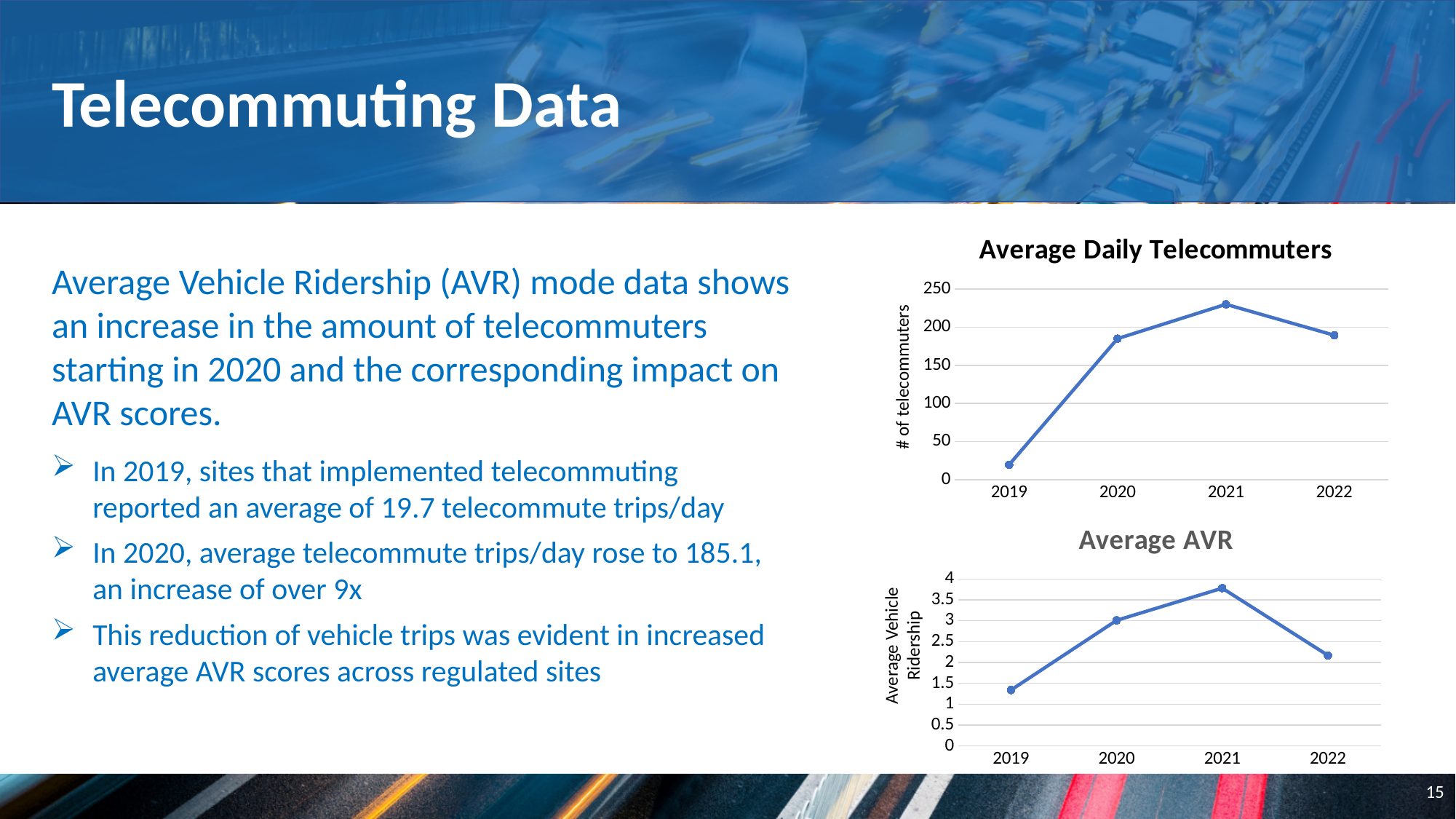
In the "Average Daily Telecommuters" chart, which year has the lowest value? 2019 What kind of chart is the "Average Daily Telecommuters" chart? line chart In the "Average Daily Telecommuters" chart, which year has the highest value? 2021 In the "Average Daily Telecommuters" chart, do the values rise or fall from 2019 to 2021? rise In the "Average AVR" chart, is the value for 2021 greater or less than 3.5? greater In the "Average AVR" chart, which year has the lowest value? 2019 In the "Average AVR" chart, which year has the larger value, 2020 or 2022? 2020 What is the y-axis label of the "Average Daily Telecommuters" chart? # of telecommuters In the "Average Daily Telecommuters" chart, is the value for 2019 greater or less than 50? less How many years are plotted in the "Average Daily Telecommuters" chart? 4 In the "Average AVR" chart, which year has the highest value? 2021 In the "Average Daily Telecommuters" chart, is the value for 2020 greater or less than 150? greater